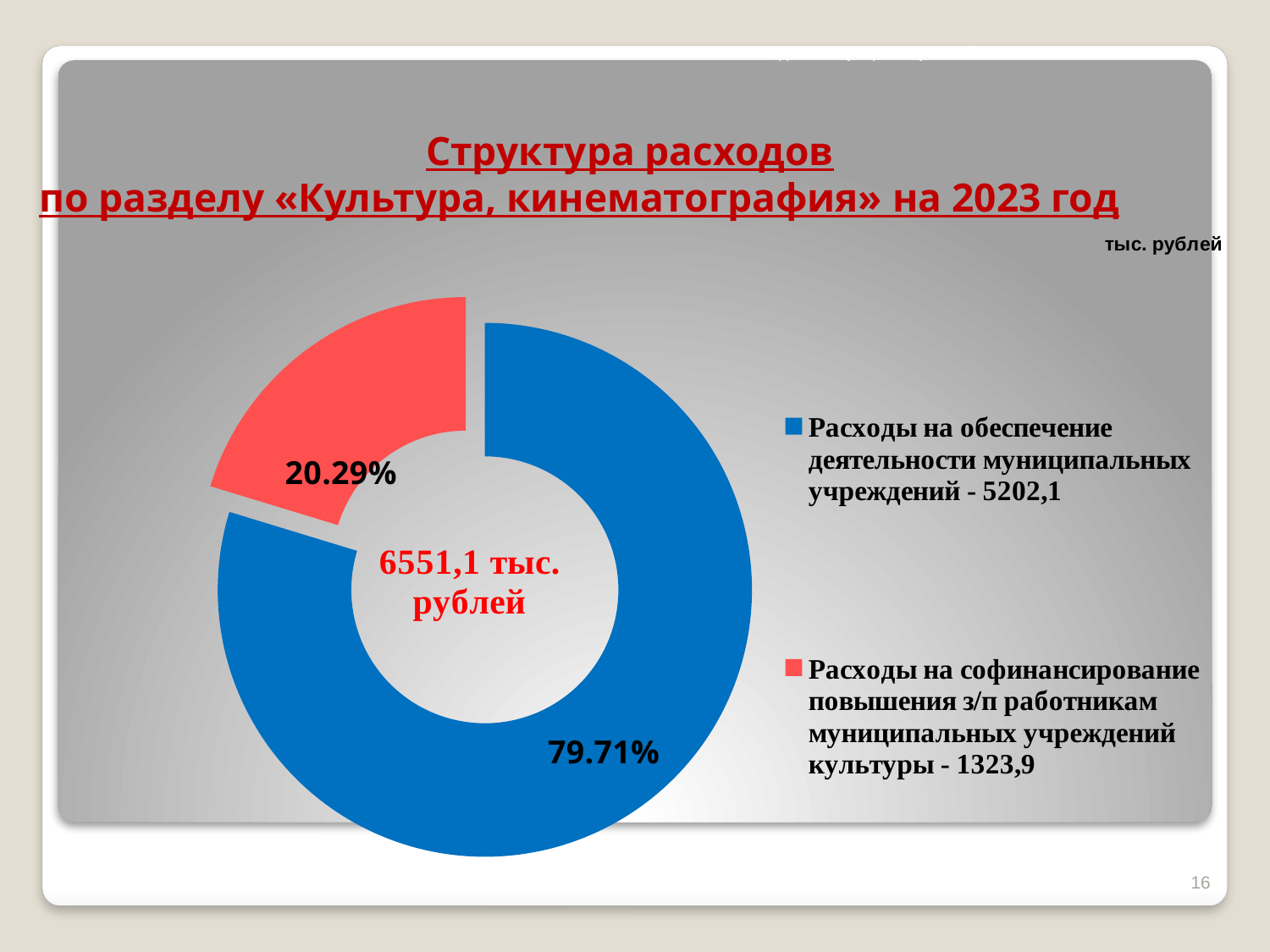
How many categories does the chart show? 2 What share of expenditure is labelled for «Расходы на софинансирование повышения з/п работникам муниципальных учреждений культуры»? 20.29% What value (тыс. рублей) does the legend give for «Расходы на софинансирование повышения з/п работникам муниципальных учреждений культуры»? 1323,9 What total amount is shown in the centre of the chart? 6551,1 тыс. рублей Which category has the smallest share of the chart? Расходы на софинансирование повышения з/п работникам муниципальных учреждений культуры Which colour represents «Расходы на софинансирование повышения з/п работникам муниципальных учреждений культуры»? Red What share of expenditure is labelled for «Расходы на обеспечение деятельности муниципальных учреждений»? 79.71% What is the title of the chart on the slide? Структура расходов по разделу «Культура, кинематография» на 2023 год Which category has the largest share of the chart? Расходы на обеспечение деятельности муниципальных учреждений What value (тыс. рублей) does the legend give for «Расходы на обеспечение деятельности муниципальных учреждений»? 5202,1 What kind of chart is shown on the slide? Doughnut (pie) chart What is the difference in percentage points between the two slices (79.71% and 20.29%)? 59.42 percentage points